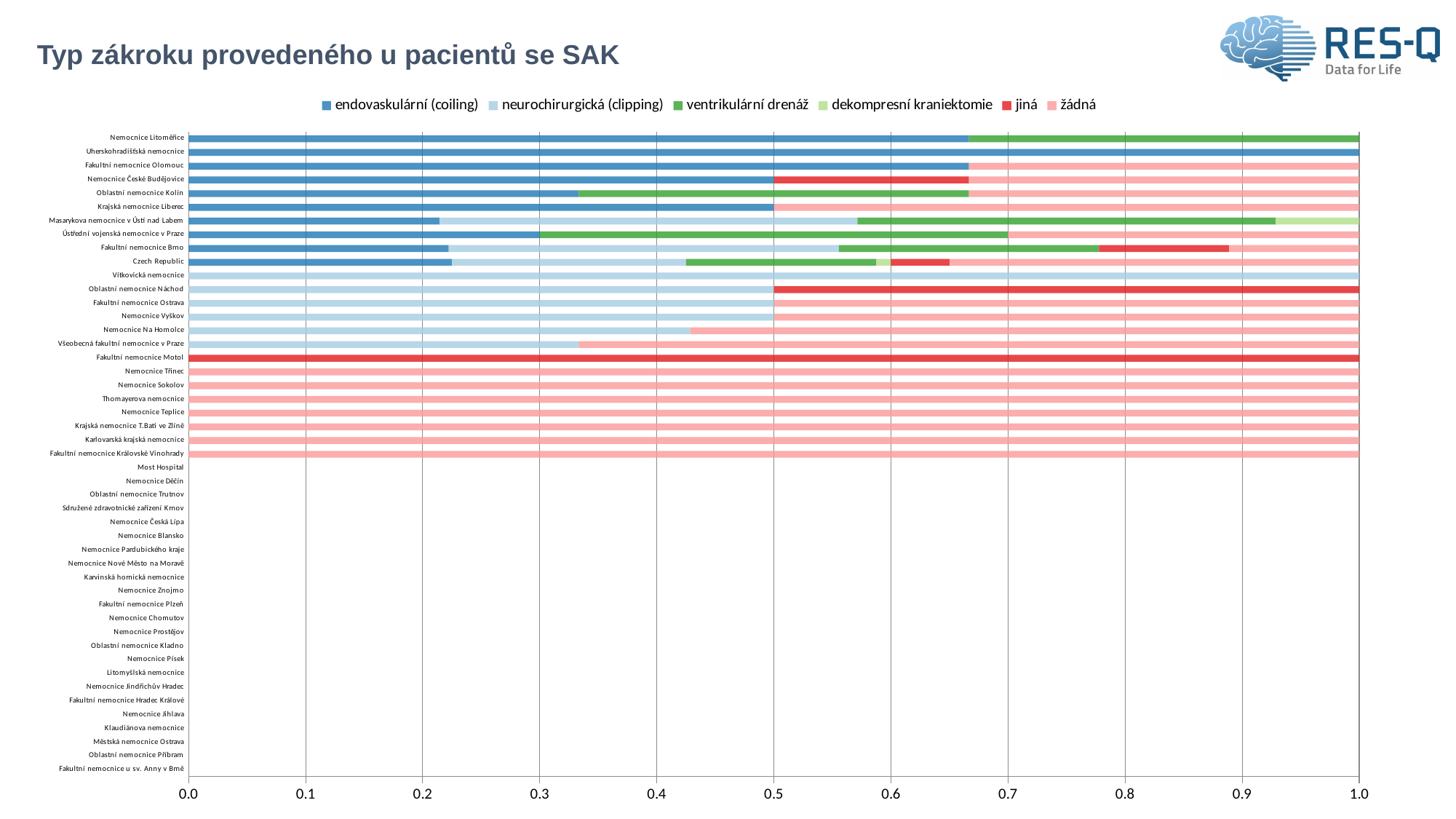
Is the value of endovaskulární (coiling) for Fakultní nemocnice Brno greater or less than 0.3? less What kind of chart is shown on the slide? Stacked bar chart What is the value of endovaskulární (coiling) for Uherskohradišťská nemocnice? 1.0 What is the value of neurochirurgická (clipping) for Nemocnice Vyškov? 0.5 What is the value of endovaskulární (coiling) for Ústřední vojenská nemocnice v Praze? 0.3 What is the title of the chart? Typ zákroku provedeného u pacientů se SAK How many series does the legend list? 6 Which has the larger endovaskulární (coiling) value, Fakultní nemocnice Olomouc or Krajská nemocnice Liberec? Fakultní nemocnice Olomouc Is the value of neurochirurgická (clipping) for Nemocnice Na Homolce greater or less than 0.4? greater What is the value of jiná for Fakultní nemocnice Motol? 1.0 What is the value of endovaskulární (coiling) for Krajská nemocnice Liberec? 0.5 How many hospitals (categories) are listed on the vertical axis? 47